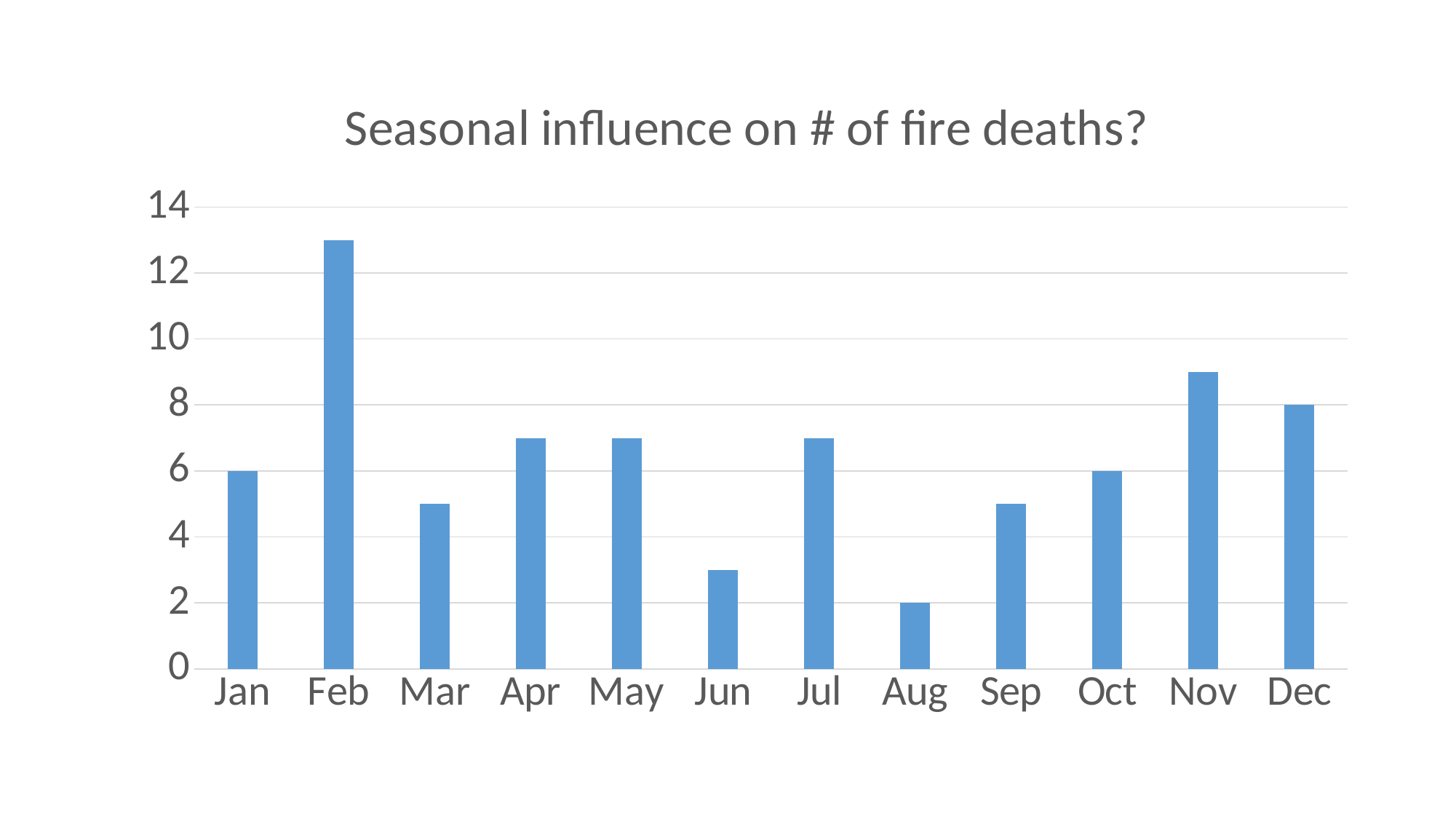
Which month has the highest number of fire deaths? Feb Which month has the lowest number of fire deaths? Aug What is the title of the chart? Seasonal influence on # of fire deaths? Is the value for Jun greater or less than 4? less What is the value for Jan? 6 Is the value for Feb greater or less than 12? greater How many months are shown on the x axis of the chart? 12 What is the value for Aug? 2 What is the value for Dec? 8 What type of chart is shown on the slide? bar chart What is the difference between the values for Dec and Aug? 6 Which is larger, the value for Feb or the value for Nov? Feb